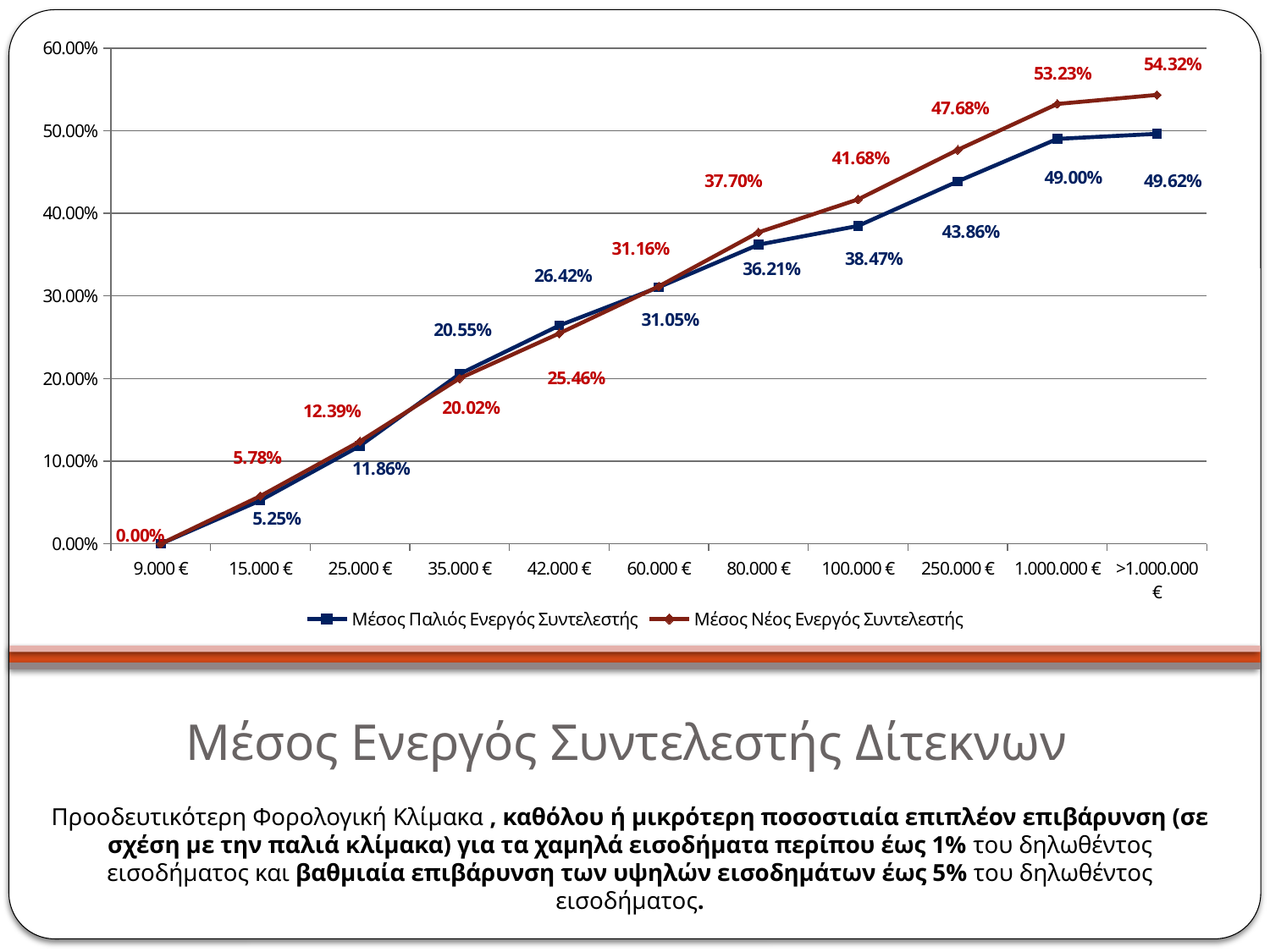
What is the difference between Μέσος Νέος Ενεργός Συντελεστής and Μέσος Παλιός Ενεργός Συντελεστής at 1.000.000 €? 4.23% How many income categories are shown on the x axis? 11 What kind of chart is shown on the slide? line chart Do the values of Μέσος Νέος Ενεργός Συντελεστής rise or fall as income increases along the x axis? rise How many series does the legend list? 2 Which colour is used for the Μέσος Νέος Ενεργός Συντελεστής line? red At 35.000 €, which series has the larger value, Μέσος Παλιός Ενεργός Συντελεστής or Μέσος Νέος Ενεργός Συντελεστής? Μέσος Παλιός Ενεργός Συντελεστής Which income category has the lowest value for Μέσος Νέος Ενεργός Συντελεστής? 9.000 € What is the value of Μέσος Παλιός Ενεργός Συντελεστής at 35.000 €? 20.55% Which income category has the highest value for Μέσος Παλιός Ενεργός Συντελεστής? >1.000.000 € What is the value of Μέσος Νέος Ενεργός Συντελεστής at >1.000.000 €? 54.32% What is the value of Μέσος Νέος Ενεργός Συντελεστής at 100.000 €? 41.68%